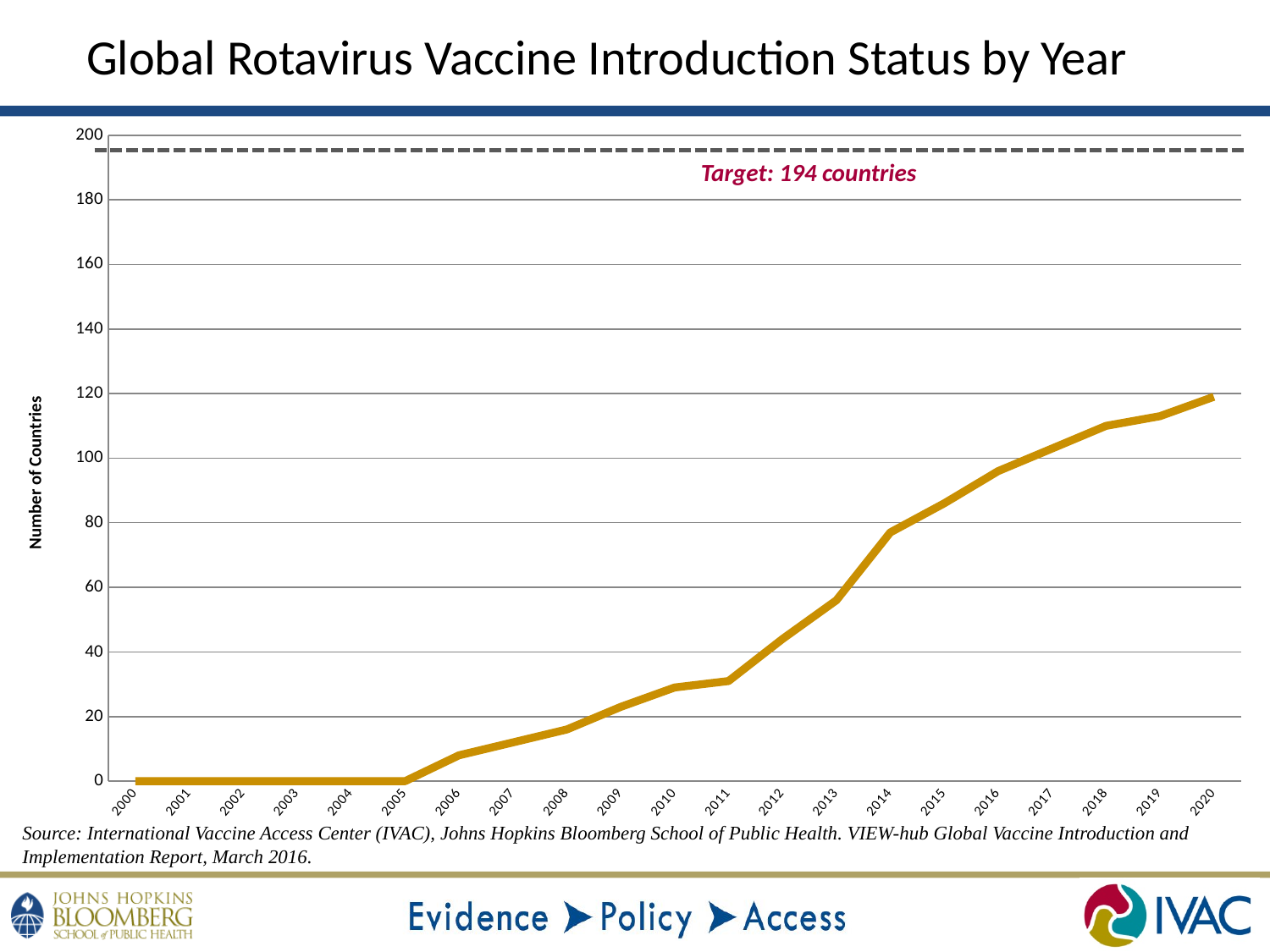
What target value is marked by the dashed line? 194 countries What is the title of the chart? Global Rotavirus Vaccine Introduction Status by Year Is the value for 2014 greater or less than 60? greater What kind of chart is shown on the slide? line chart What is the number of countries in 2003? 0 Is the value for 2008 greater or less than 20? less Do the values rise or fall from 2005 to 2020? rise How many years are shown along the x axis? 21 Which year has the larger number of countries, 2010 or 2014? 2014 What is the label on the vertical axis? Number of Countries Is the value for 2018 greater or less than 100? greater Which year has the highest number of countries? 2020